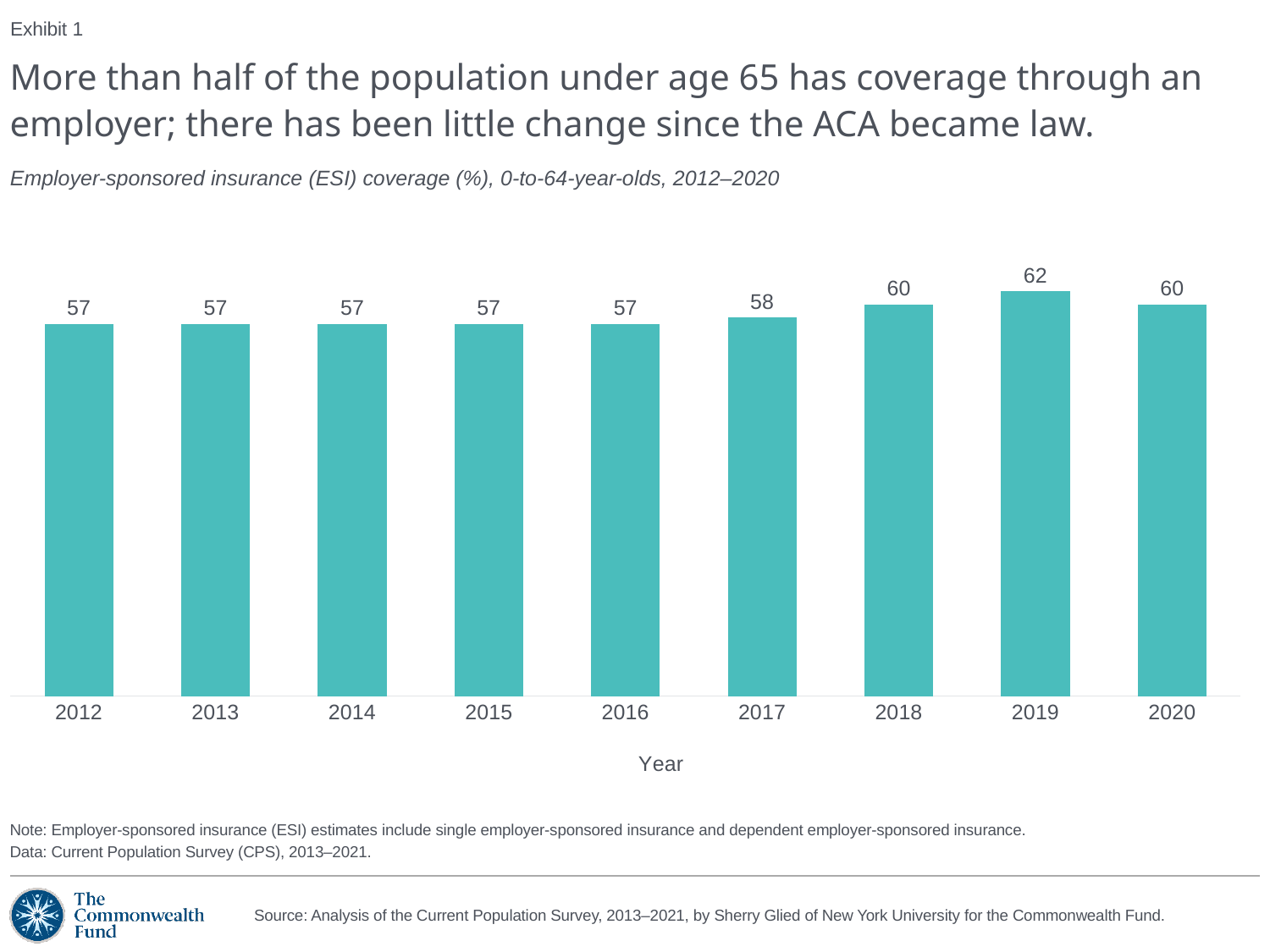
What is the ESI coverage value for 2020? 60 Which year has the highest ESI coverage value? 2019 What is the ESI coverage value for 2017? 58 What is the ESI coverage value for 2019? 62 Which is larger, the value for 2019 or the value for 2020? 2019 What is the difference between the ESI coverage values for 2018 and 2017? 2 What is the value for 2016? 57 What kind of chart is shown on the slide? Bar chart What is the difference between the ESI coverage values for 2019 and 2012? 5 Do the values generally rise or fall from 2012 to 2019? Rise What is the label of the x axis? Year How many years are shown on the x axis? 9